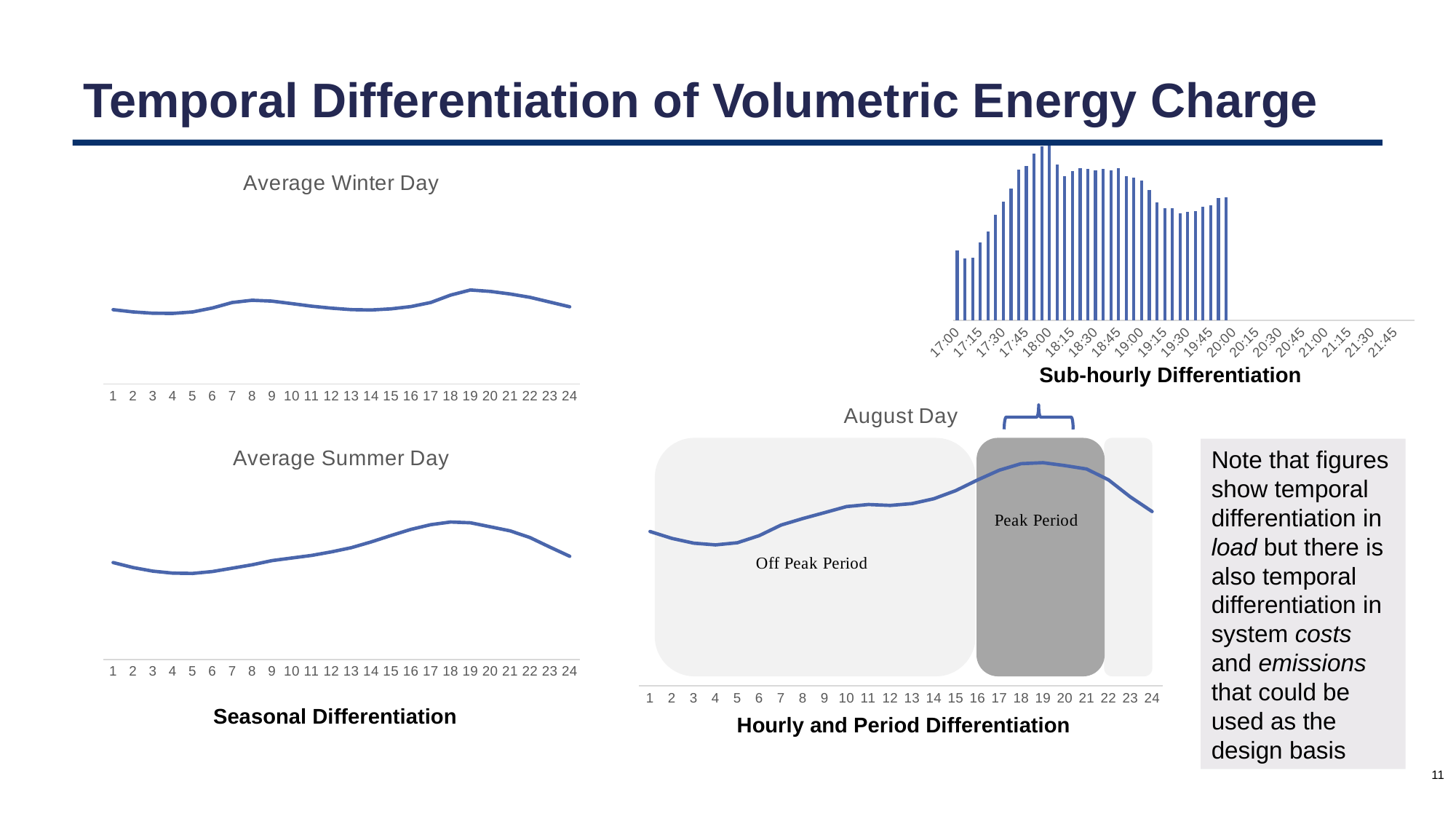
In the August Day chart, do the values rise or fall between hour 5 and hour 19? rise How many time labels are shown on the x axis of the Sub-hourly Differentiation chart? 20 In the August Day chart, is the value at hour 24 larger or smaller than the value at hour 1? larger In the Sub-hourly Differentiation chart, is the bar at 17:00 taller or shorter than the bar at 18:00? shorter In the Average Winter Day chart, is the value at hour 8 larger or smaller than the value at hour 4? larger What kind of chart is the Average Winter Day chart? line chart In the Average Winter Day chart, which hour has the highest value? 19 How many hourly points are shown on the x axis of the Average Winter Day chart? 24 In the August Day chart, which period is shaded in the darker grey? Peak Period In the Average Summer Day chart, do the values rise or fall between hour 5 and hour 18? rise What kind of chart is the Sub-hourly Differentiation chart? bar chart